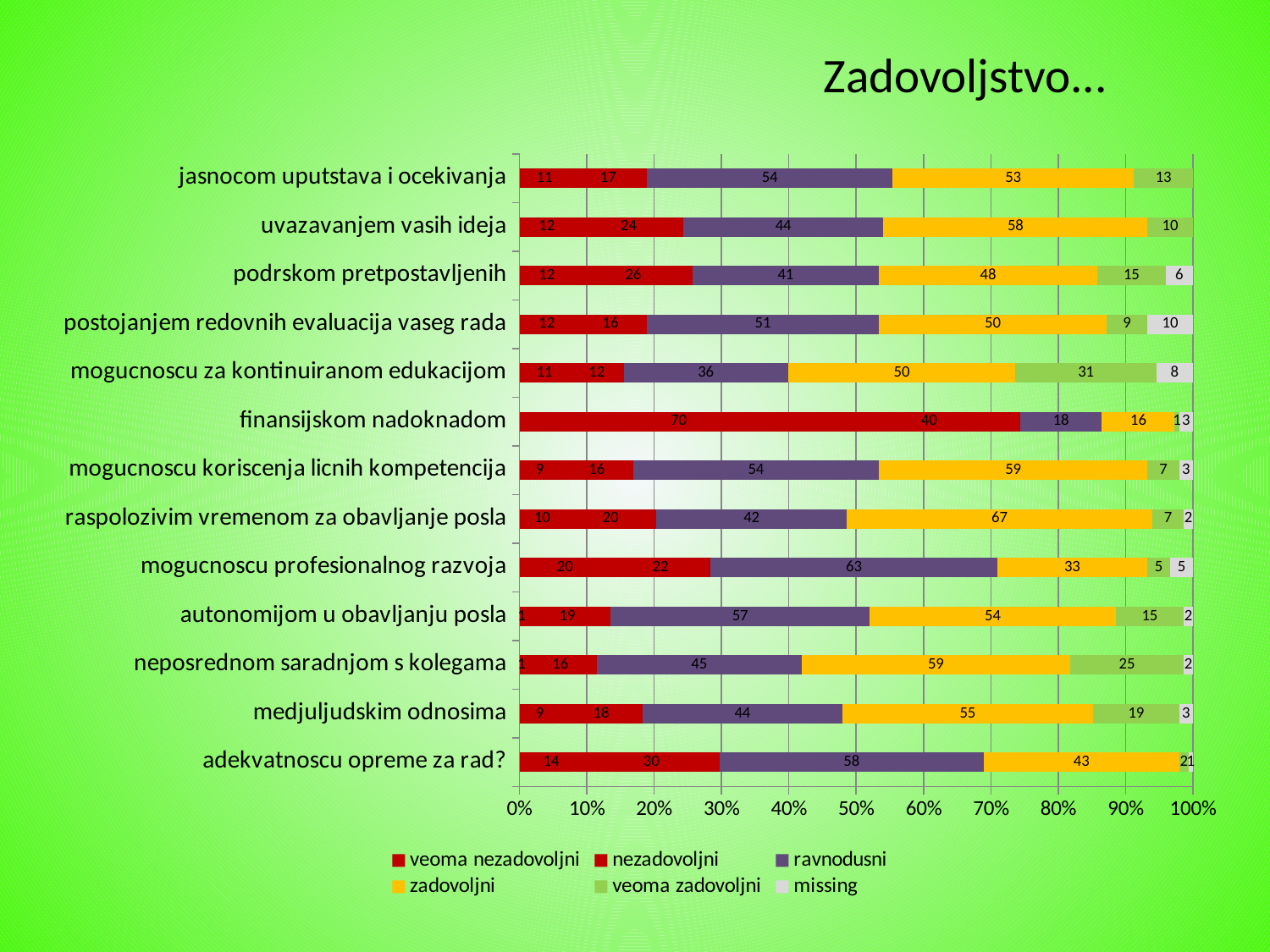
What is the 'veoma zadovoljni' value for 'neposrednom saradnjom s kolegama'? 25 How many categories are shown on the vertical axis? 13 Which category has the highest 'veoma nezadovoljni' value? finansijskom nadoknadom Which category has the highest 'ravnodusni' value? mogucnoscu profesionalnog razvoja Which is larger: the 'nezadovoljni' value for 'adekvatnoscu opreme za rad?' or for 'medjuljudskim odnosima'? adekvatnoscu opreme za rad? What is the 'ravnodusni' value for 'jasnocom uputstava i ocekivanja'? 54 What is the 'veoma zadovoljni' value for 'mogucnoscu za kontinuiranom edukacijom'? 31 What is the difference between the 'zadovoljni' values for 'uvazavanjem vasih ideja' and 'podrskom pretpostavljenih'? 10 What is the title of the chart? Zadovoljstvo… What is the 'zadovoljni' value for 'raspolozivim vremenom za obavljanje posla'? 67 How many series does the legend list? 6 What type of chart is shown on the slide? stacked bar chart